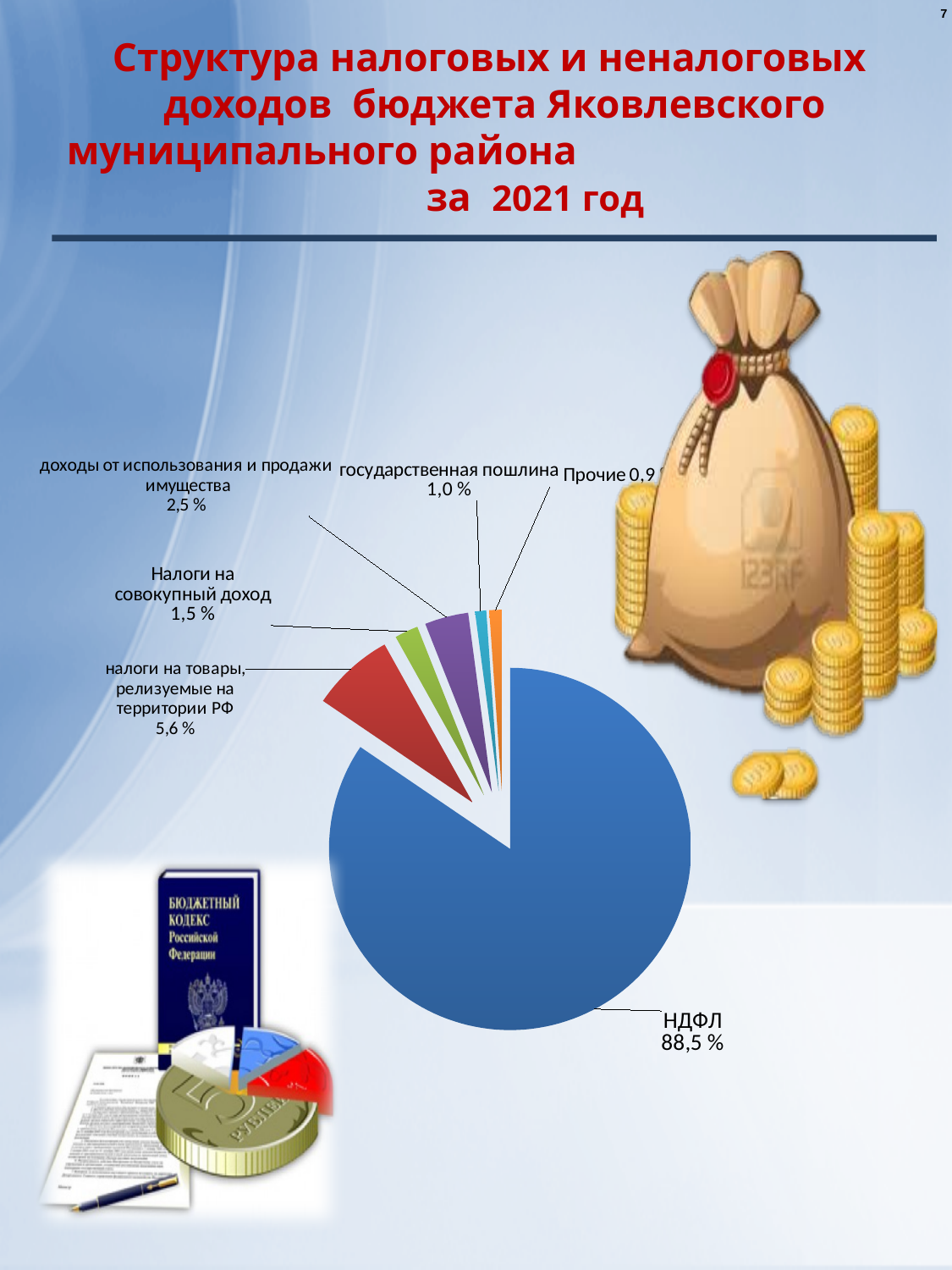
What is the difference between the share of НДФЛ and the share of налоги на товары, реализуемые на территории РФ? 82,9 % Which is larger: доходы от использования и продажи имущества or Налоги на совокупный доход? доходы от использования и продажи имущества What is the value shown for Прочие? 0,9 How many slices does the pie chart have? 6 What is the value shown for Налоги на совокупный доход? 1,5 % What is the value shown for доходы от использования и продажи имущества? 2,5 % What kind of chart is shown on the slide? pie chart What share of the pie does НДФЛ have? 88,5 % What is the value shown for налоги на товары, реализуемые на территории РФ? 5,6 % What is the value shown for государственная пошлина? 1,0 % Which category has the largest slice of the pie? НДФЛ Which category has the smallest slice of the pie? Прочие